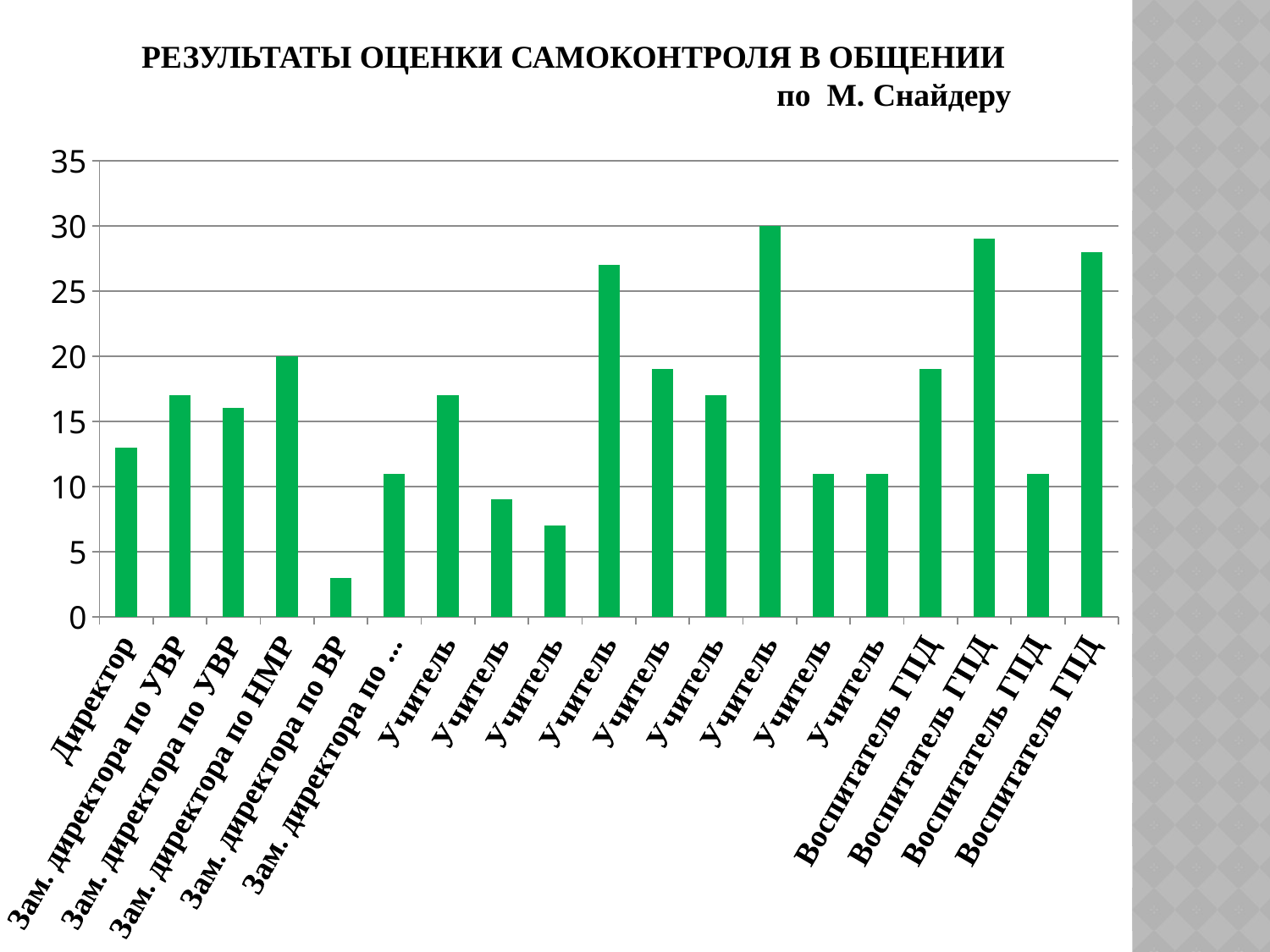
Is the value for Директор greater or less than 10? greater Is the value for the last Воспитатель ГПД bar greater or less than 25? greater Which is larger, the value for Директор or the value for Зам. директора по НМР? Зам. директора по НМР Is the value for the first Воспитатель ГПД bar greater or less than 15? greater What kind of chart is shown on the slide? bar chart What colour are the bars in the chart? green What is the title of the chart? РЕЗУЛЬТАТЫ ОЦЕНКИ САМОКОНТРОЛЯ В ОБЩЕНИИ по М. Снайдеру What is the value for Зам. директора по НМР? 20 Which category has the lowest value in the chart? Зам. директора по ВР How many bars (categories) are plotted in the chart? 19 Which is larger, the value for Директор or the value for Зам. директора по ВР? Директор